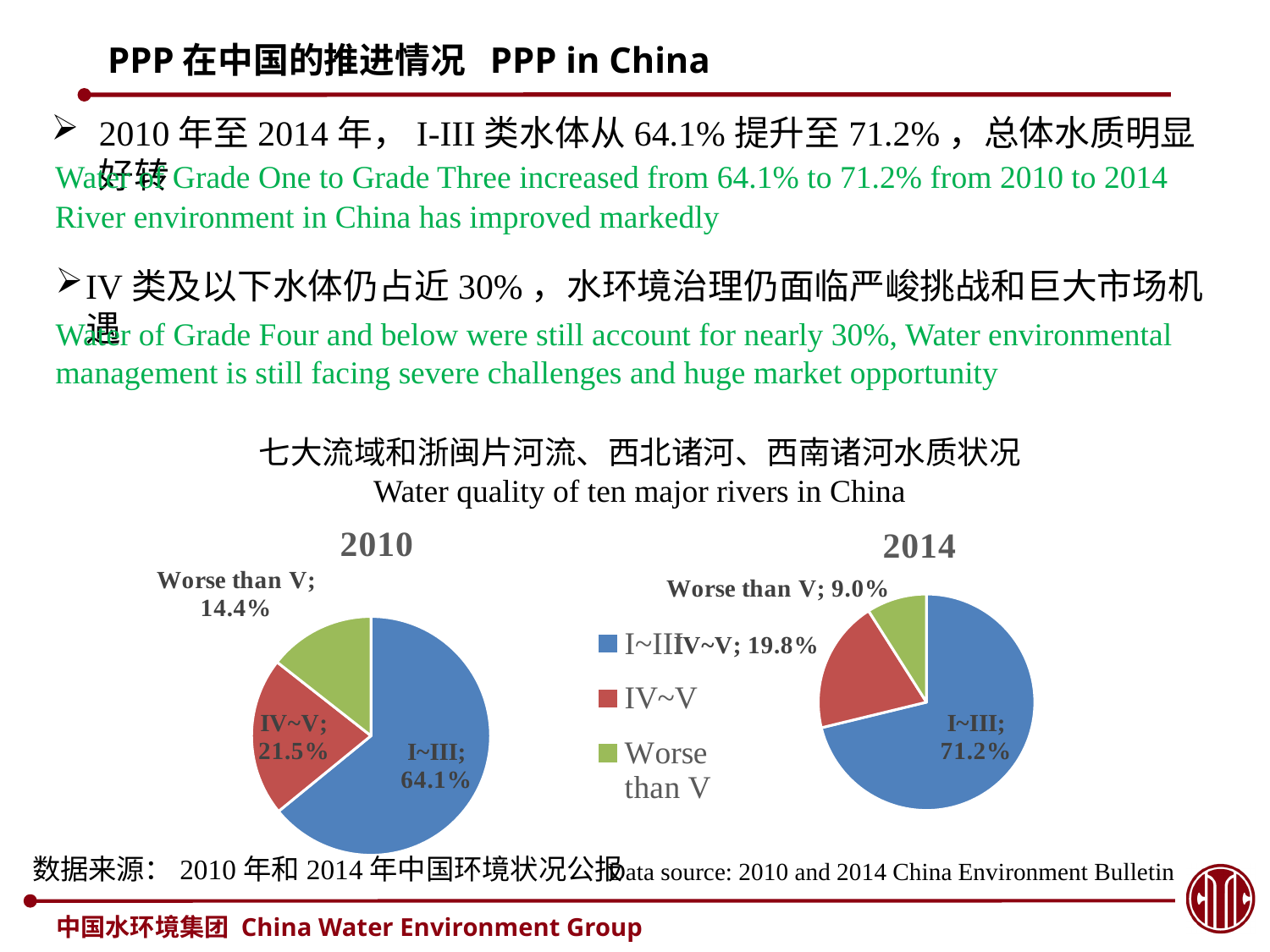
In the 2010 pie chart, what is the share for Worse than V? 14.4% In the 2010 pie chart, what is the share for I~III? 64.1% How many categories does each pie chart show? 3 Which is larger: the IV~V share in 2010 or the IV~V share in 2014? 2010 What is the difference between the I~III share in 2014 and the I~III share in 2010? 7.1% In the 2014 pie chart, what is the share for Worse than V? 9.0% How many entries does the legend between the two pie charts list? 3 In the 2014 pie chart, what is the share for IV~V? 19.8% In the 2014 pie chart, which category has the largest share? I~III What type of chart is used to show the 2010 and 2014 water quality data? Pie chart In the 2010 pie chart, which category has the smallest share? Worse than V In the 2010 pie chart, what is the difference between the IV~V share and the Worse than V share? 7.1%